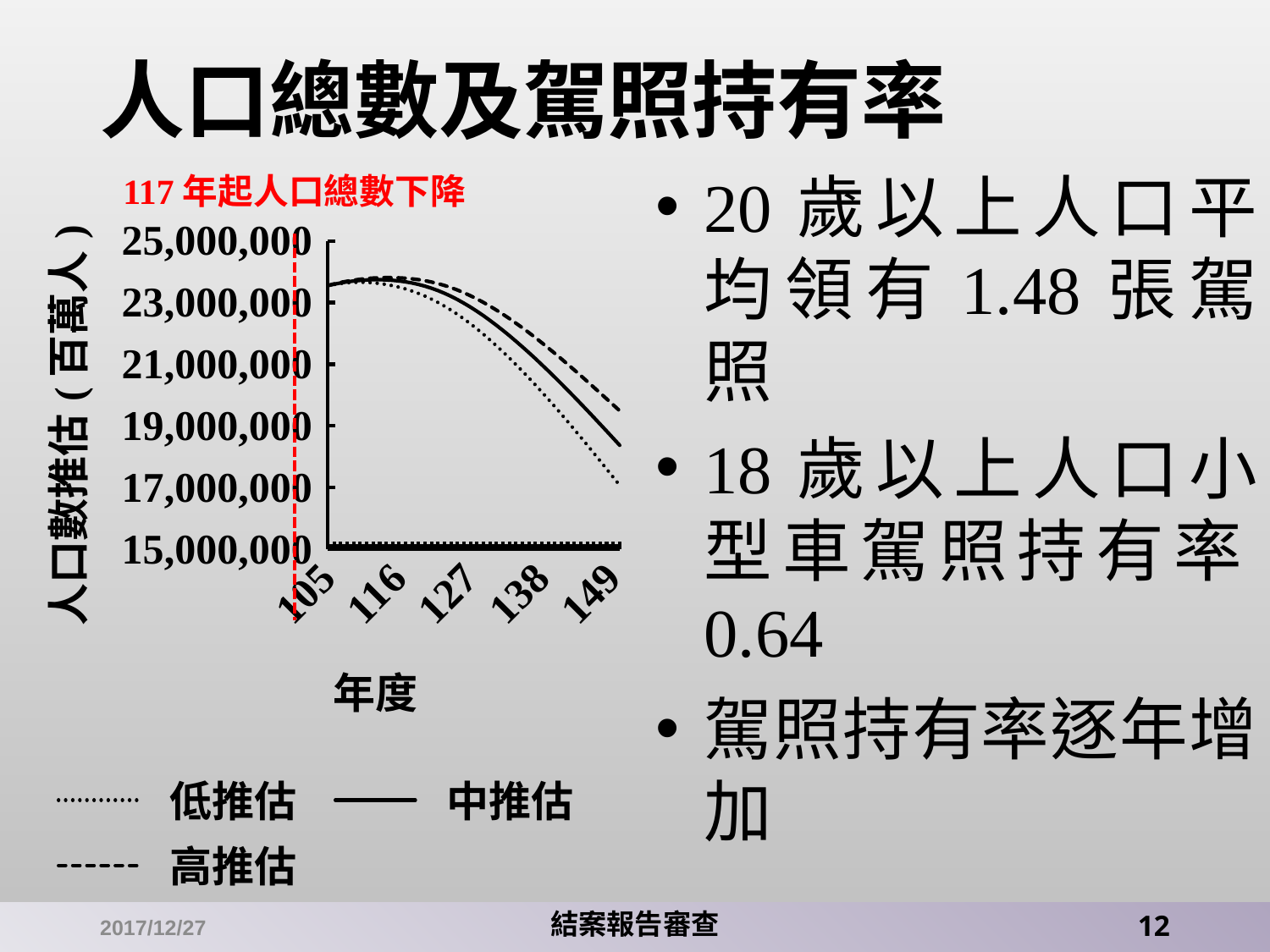
At year 149, which series is higher, 高推估 or 低推估? 高推估 Do the population estimate lines rise or fall from year 127 to year 149? fall Which series is drawn with a dashed line according to the legend? 高推估 What kind of chart is shown on the slide? line chart How many tick labels are shown on the x axis of the chart? 5 Which series has the lowest value at year 149? 低推估 According to the red annotation above the chart, from which year does the total population start to decline? 117 How many series does the chart's legend list? 3 Is the value of 中推估 at year 116 greater or less than 21,000,000? greater Is the value of 低推估 at year 149 greater or less than 19,000,000? less Is the value of 高推估 at year 149 greater or less than 21,000,000? less What is the title of the x axis of the chart? 年度